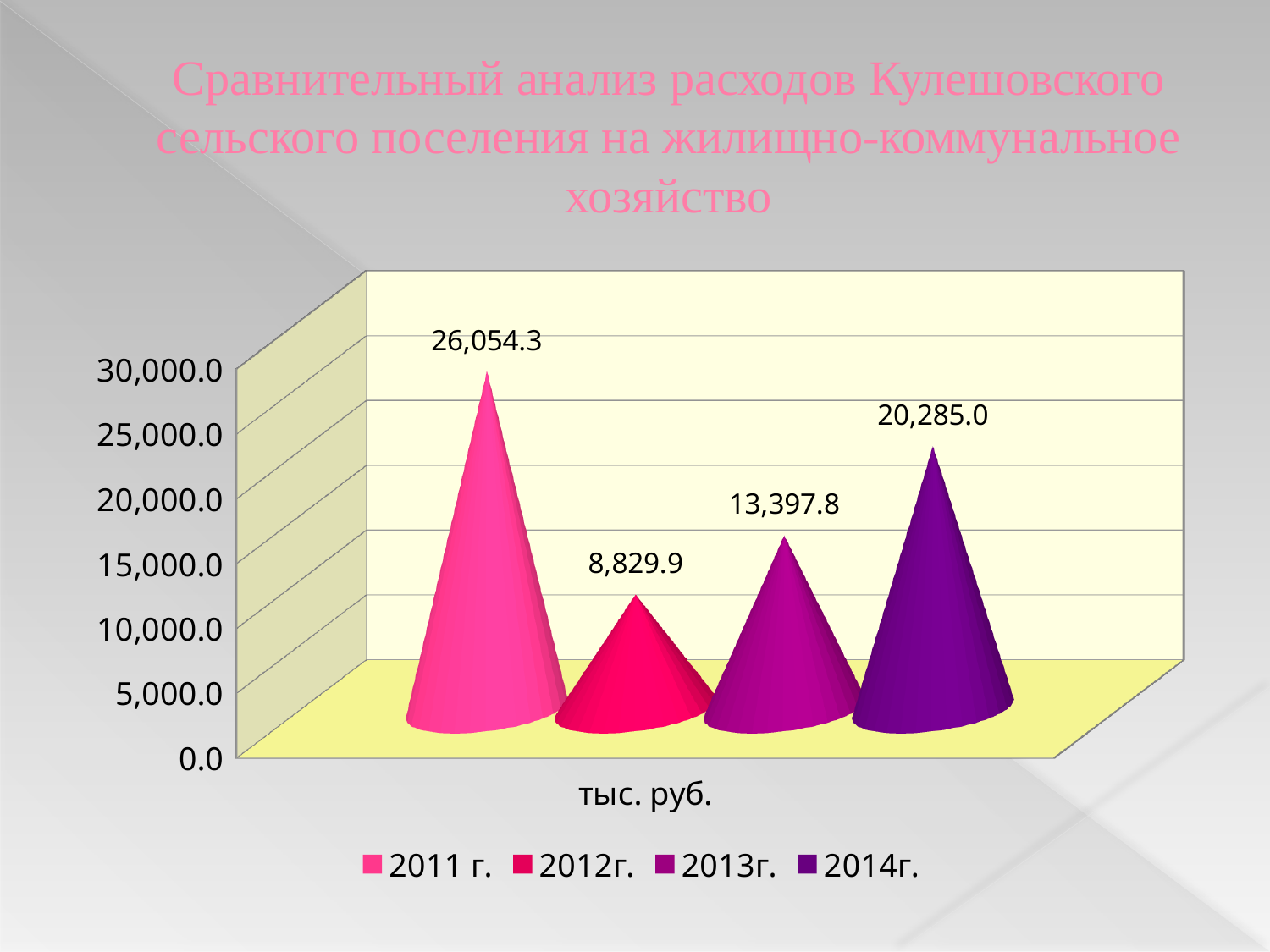
How many series does the legend list? 4 What unit is shown on the horizontal axis label? тыс. руб. Is the value for 2012г. greater or less than 10,000.0? less What is the value for 2013г.? 13,397.8 What is the difference between the values for 2011 г. and 2012г.? 17,224.4 What is the value for 2014г.? 20,285.0 What is the value for 2011 г.? 26,054.3 What is the value for 2012г.? 8,829.9 What is the difference between the values for 2014г. and 2013г.? 6,887.2 Which is larger, the value for 2013г. or the value for 2014г.? 2014г. Which year has the lowest value? 2012г. Which year has the highest value? 2011 г.